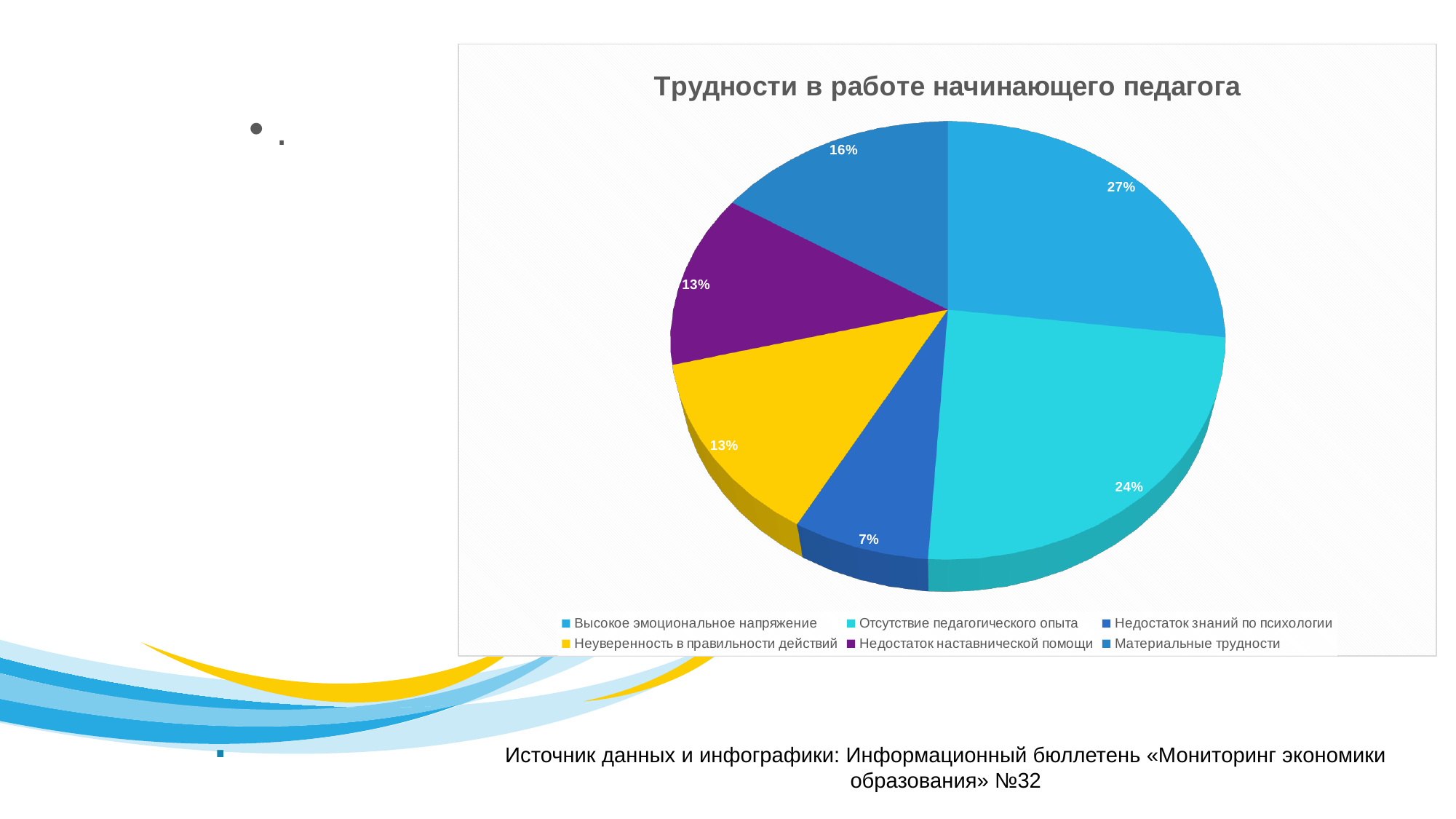
What share of the pie is labelled for "Недостаток наставнической помощи"? 13% What type of chart is shown on the slide? Pie chart Which category has the smallest slice of the pie? Недостаток знаний по психологии What share of the pie is labelled for "Недостаток знаний по психологии"? 7% What share of the pie is labelled for "Материальные трудности"? 16% Which category has the largest slice of the pie? Высокое эмоциональное напряжение Which is larger: the slice for "Отсутствие педагогического опыта" or the slice for "Неуверенность в правильности действий"? Отсутствие педагогического опыта How many categories does the legend list? 6 What is the difference in percentage points between "Высокое эмоциональное напряжение" and "Материальные трудности"? 11 What is the title of the chart? Трудности в работе начинающего педагога